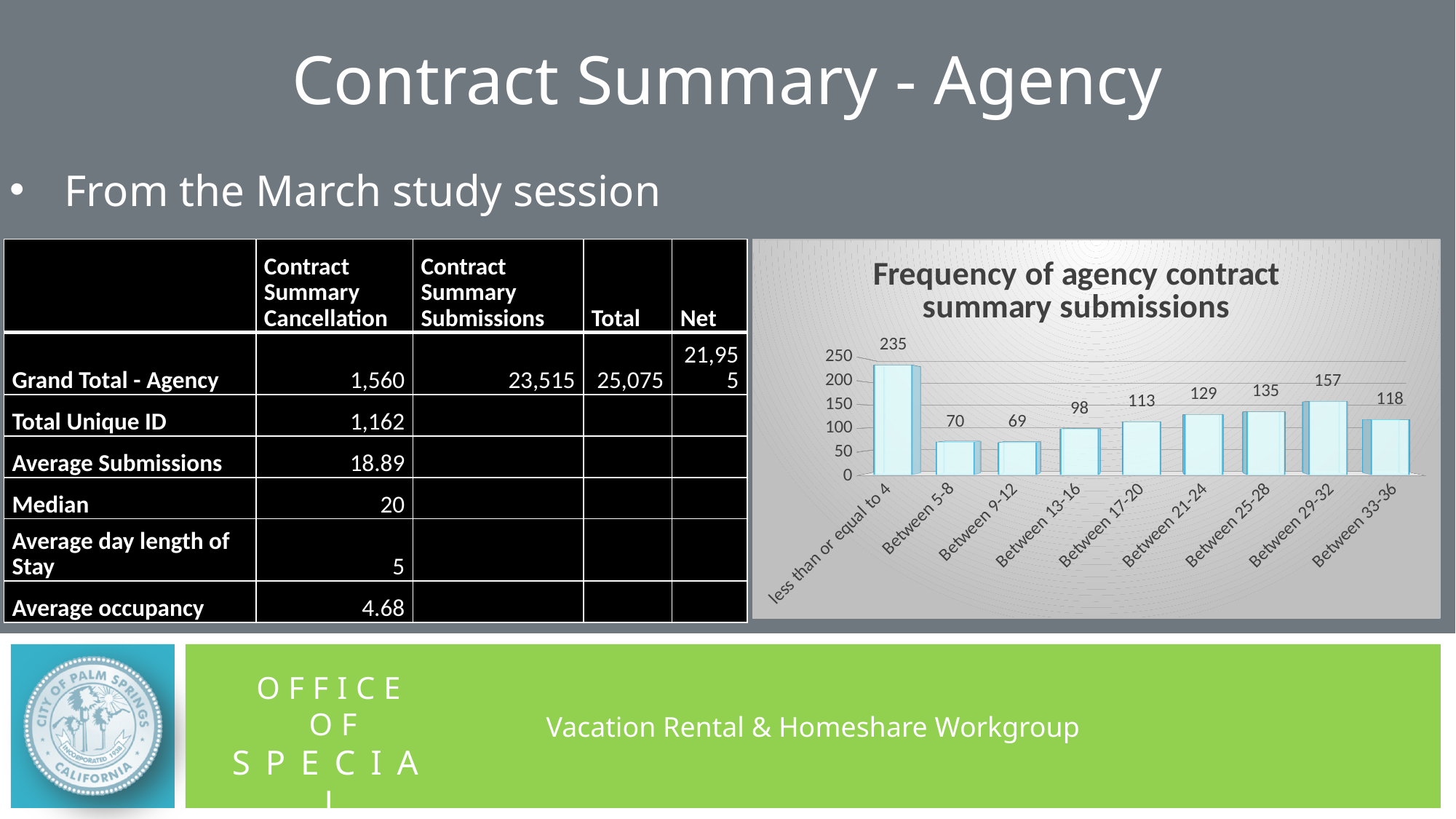
What is the difference between the values for 'Between 5-8' and 'Between 9-12'? 1 What is the difference between the values for 'less than or equal to 4' and 'Between 29-32'? 78 What is the value for 'Between 13-16' in the chart? 98 Which category has the lowest value in the chart? Between 9-12 Is the value for 'Between 25-28' greater or less than 100? greater What is the value for 'Between 29-32' in the chart? 157 How many categories are shown in the chart? 9 Which is larger, the value for 'Between 21-24' or 'Between 33-36'? Between 21-24 What kind of chart is shown on the slide? bar chart What is the title of the chart? Frequency of agency contract summary submissions Which category has the highest value in the chart? less than or equal to 4 What is the value for 'less than or equal to 4' in the Frequency of agency contract summary submissions chart? 235